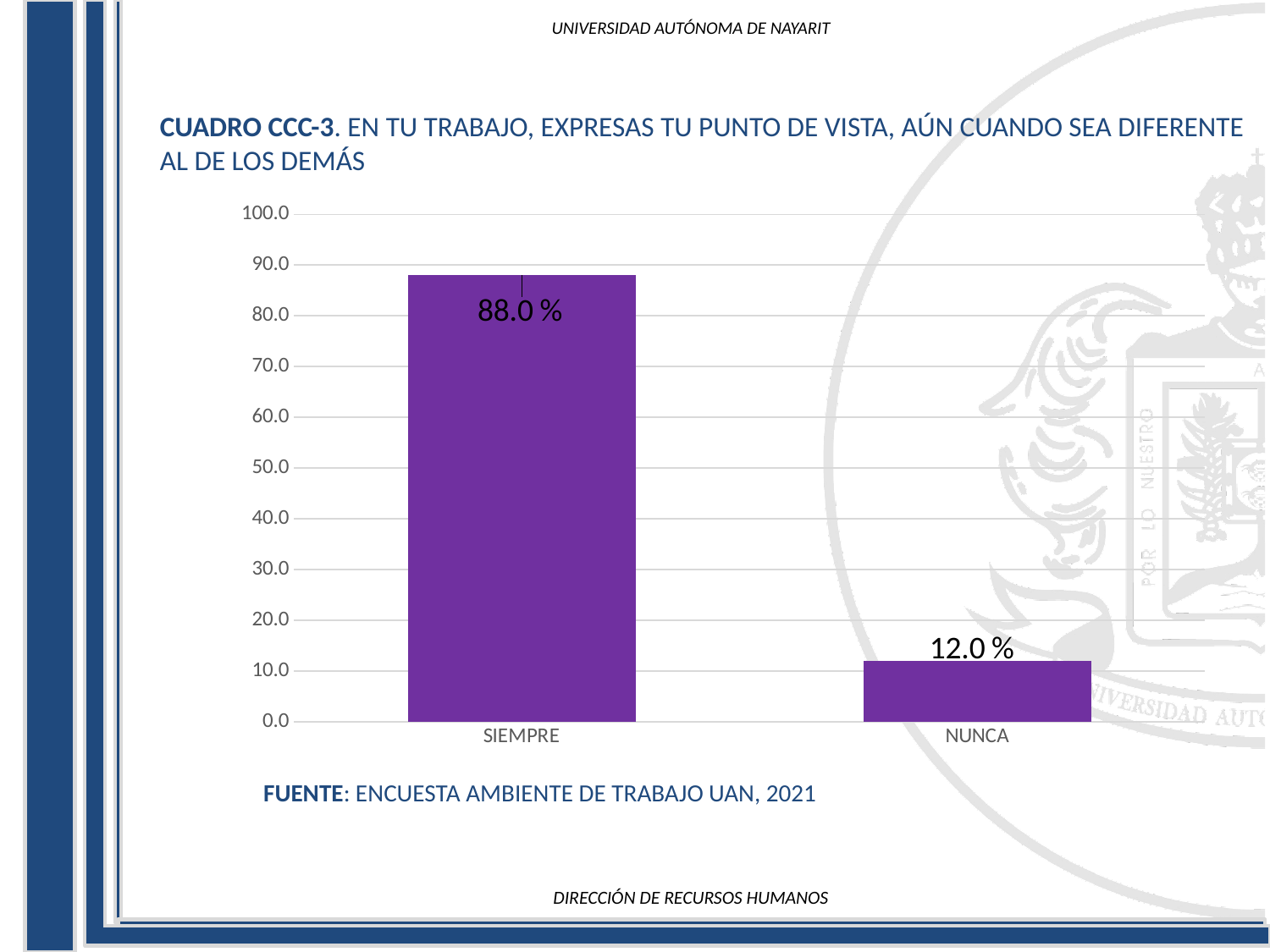
What is the value for NUNCA? 12.0 % What is the source cited below the chart? ENCUESTA AMBIENTE DE TRABAJO UAN, 2021 Is the value for SIEMPRE greater or less than 80.0? greater How many categories are shown on the x axis? 2 What kind of chart is shown on the slide? Bar chart Which is larger, the value for SIEMPRE or the value for NUNCA? SIEMPRE What is the maximum value shown on the y axis? 100.0 What is the difference between the values for SIEMPRE and NUNCA? 76.0 % Is the value for NUNCA greater or less than 20.0? less Which category has the lowest value? NUNCA What is the value for SIEMPRE? 88.0 % Which category has the highest value? SIEMPRE